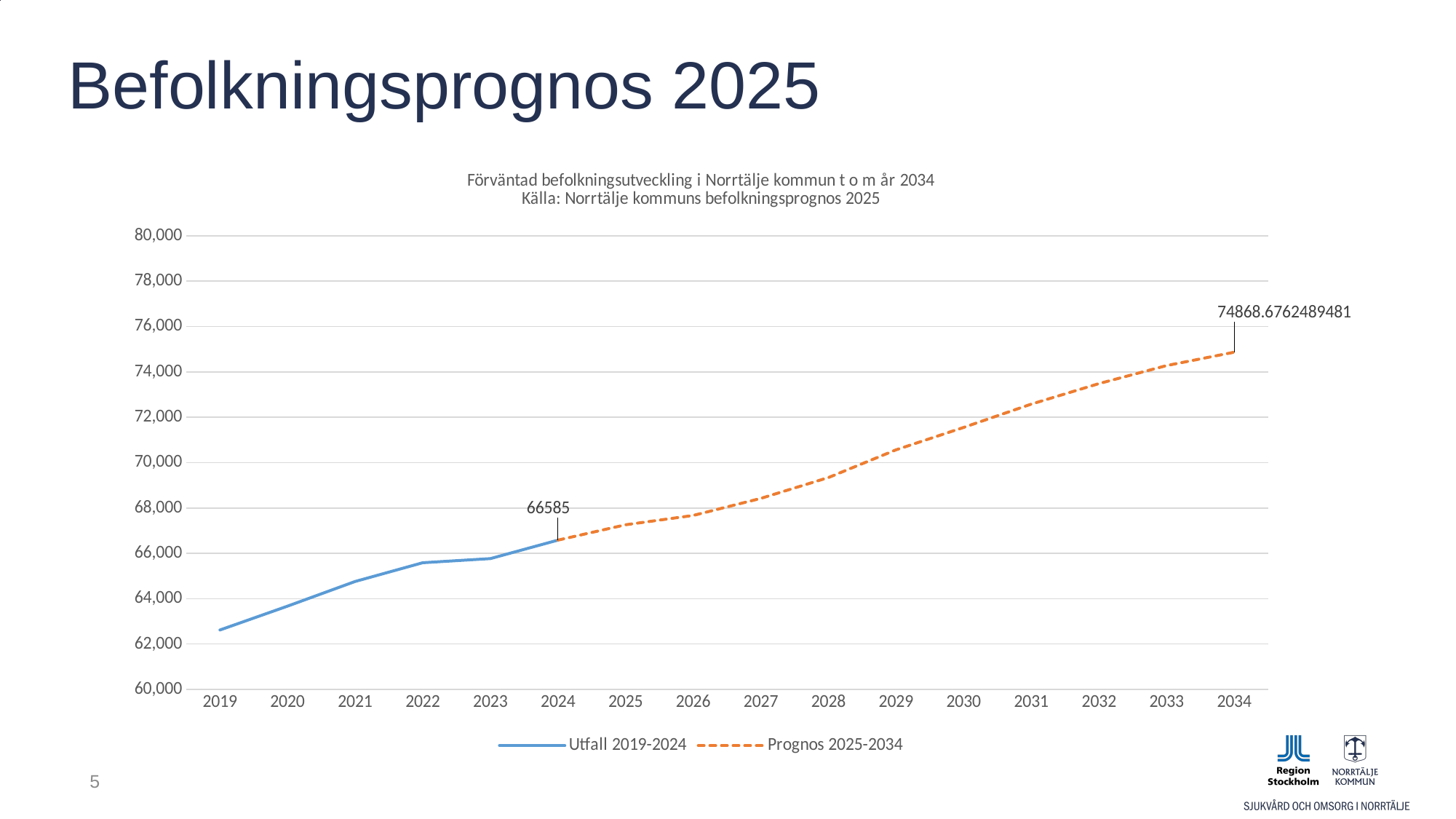
Do the values rise or fall from 2019 to 2034? rise Is the value for 2030 greater or less than 70,000? greater How many years are shown on the x axis? 16 Which series is drawn with a dashed line? Prognos 2025-2034 Is the value for 2027 greater or less than 70,000? less What is the value labelled for 2034? 74868.6762489481 What type of chart is shown on the slide? line chart Which year has the lowest value? 2019 Is the value for 2019 greater or less than 64,000? less What is the value labelled for 2024? 66585 Which year has the highest value? 2034 How many series does the legend list? 2